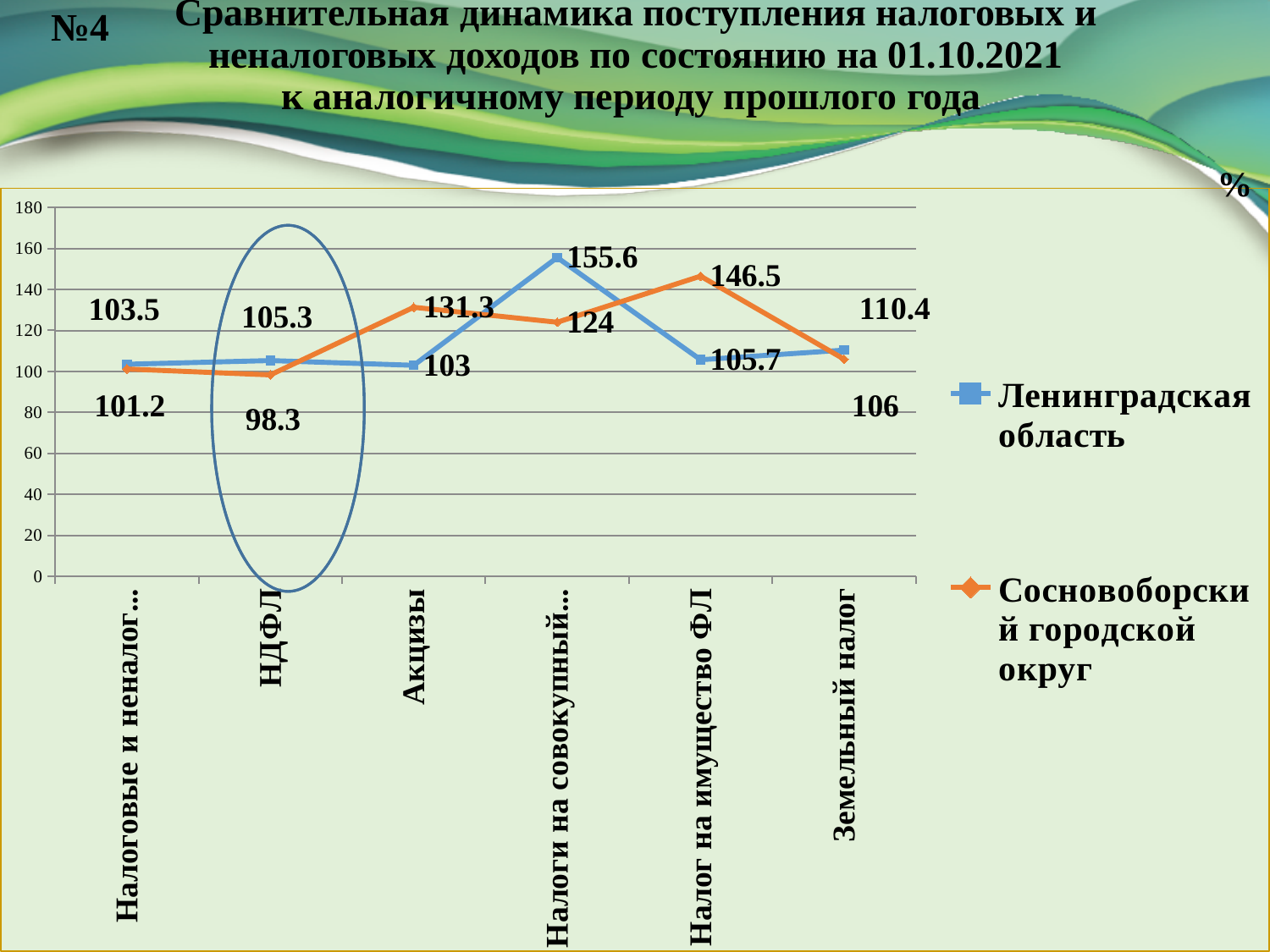
What kind of chart is shown on the slide? line chart What is the value for Сосновоборский городской округ for Акцизы? 131.3 How many categories are shown on the x axis? 6 What is the value for Сосновоборский городской округ for НДФЛ? 98.3 For Земельный налог, which series has the larger value? Ленинградская область What is the value for Ленинградская область for НДФЛ? 105.3 What is the value for Ленинградская область for Налог на имущество ФЛ? 105.7 How many series does the legend list? 2 For which category is the Сосновоборский городской округ value lowest? НДФЛ What is the difference between the Сосновоборский городской округ and Ленинградская область values for Налог на имущество ФЛ? 40.8 Which series is drawn in orange? Сосновоборский городской округ For which category is the Ленинградская область value highest? Налоги на совокупный...